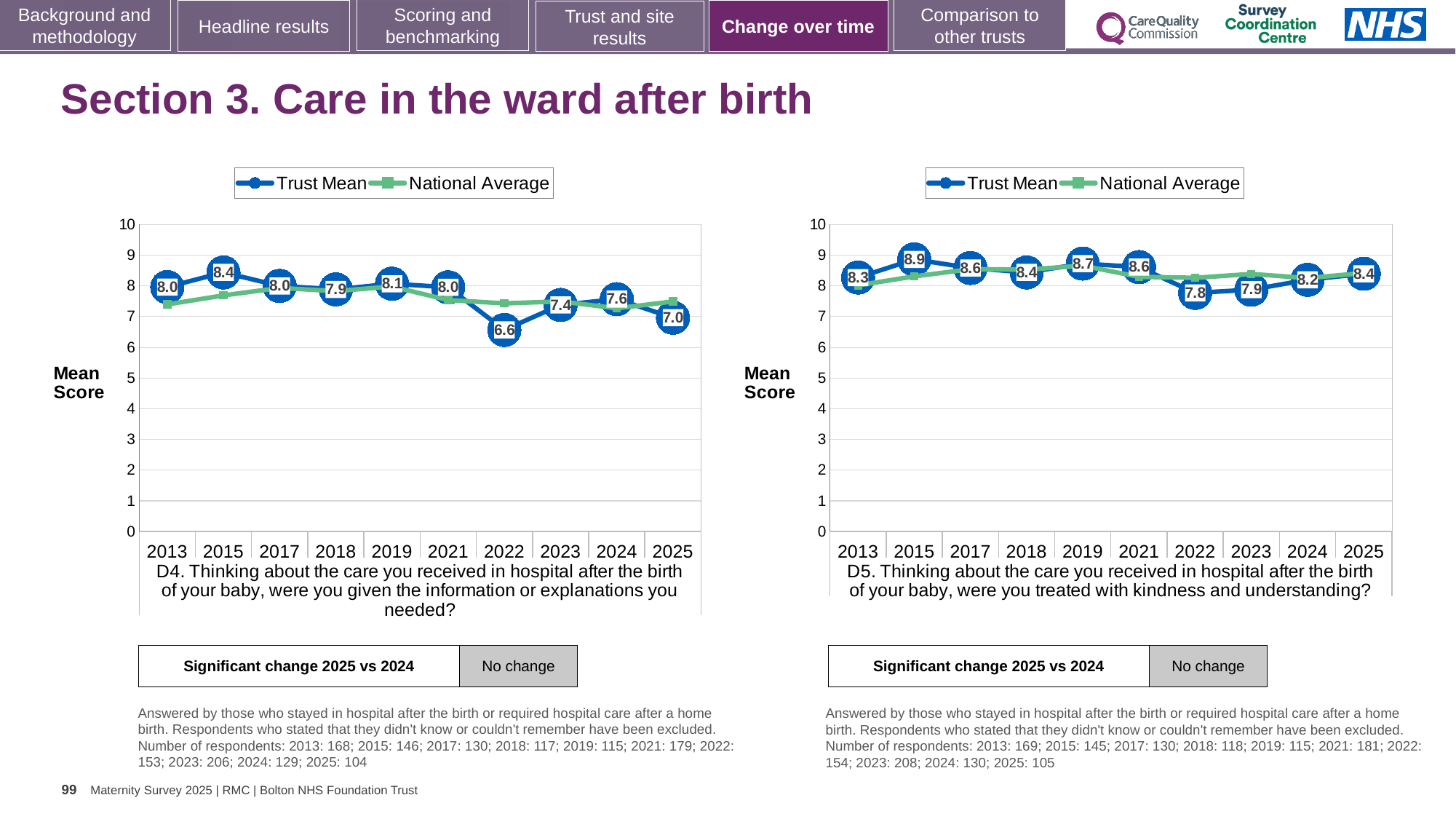
In the D4 chart on the left, which year has the highest Trust Mean score? 2015 How many years are shown on the x axis of the D5 chart on the right? 10 What type of chart is the D5 chart on the right? Line chart In the D4 chart on the left, does the Trust Mean score rise or fall from 2021 to 2022? Fall How many series does the legend of the D4 chart on the left list? 2 In the D5 chart on the right, which year has the lowest Trust Mean score? 2022 In the D4 chart on the left, what is the Trust Mean score for 2022? 6.6 In the D4 chart on the left, what is the difference between the Trust Mean scores for 2015 and 2022? 1.8 In the D5 chart on the right, what is the Trust Mean score for 2025? 8.4 In the D4 chart on the left, is the Trust Mean score higher in 2024 or in 2025? 2024 In the D5 chart on the right, what is the difference between the Trust Mean scores for 2015 and 2022? 1.1 In the D4 chart on the left, is the National Average value for 2013 greater or less than 8? less